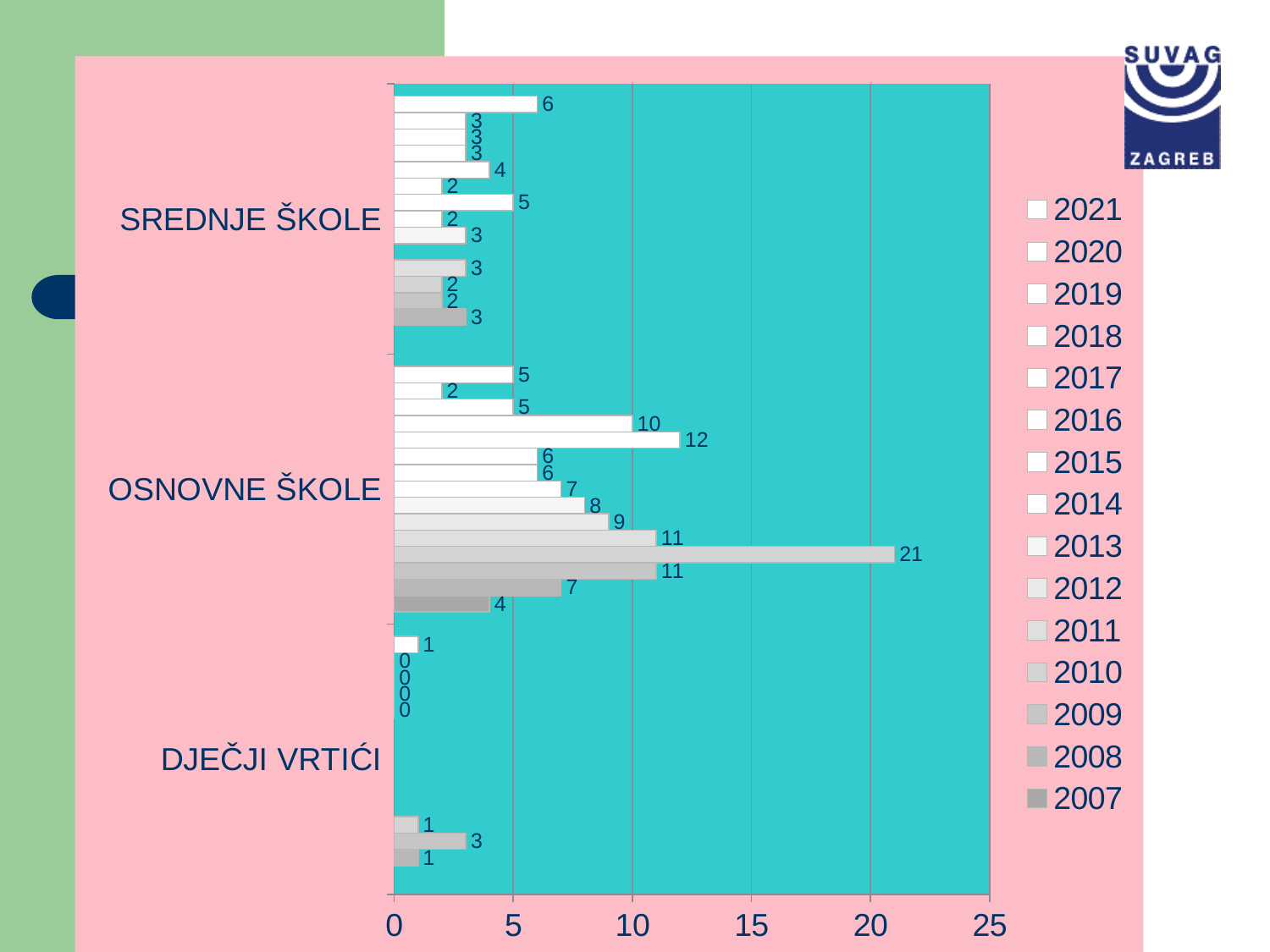
What is the value for OSNOVNE ŠKOLE in 2021? 5 How many categories are shown on the vertical axis of the chart? 3 What is the highest value shown for OSNOVNE ŠKOLE? 21 What is the value for SREDNJE ŠKOLE in 2021? 6 What is the difference between the OSNOVNE ŠKOLE values for 2010 and 2017? 9 How many series does the chart legend list? 15 What is the value for OSNOVNE ŠKOLE in 2017? 12 Which is larger in 2021: the value for SREDNJE ŠKOLE or for OSNOVNE ŠKOLE? SREDNJE ŠKOLE What is the value for DJEČJI VRTIĆI in 2021? 1 What type of chart is shown on the slide? bar chart Is the highest value for OSNOVNE ŠKOLE greater or less than 20? greater Which year has the highest value for OSNOVNE ŠKOLE? 2010